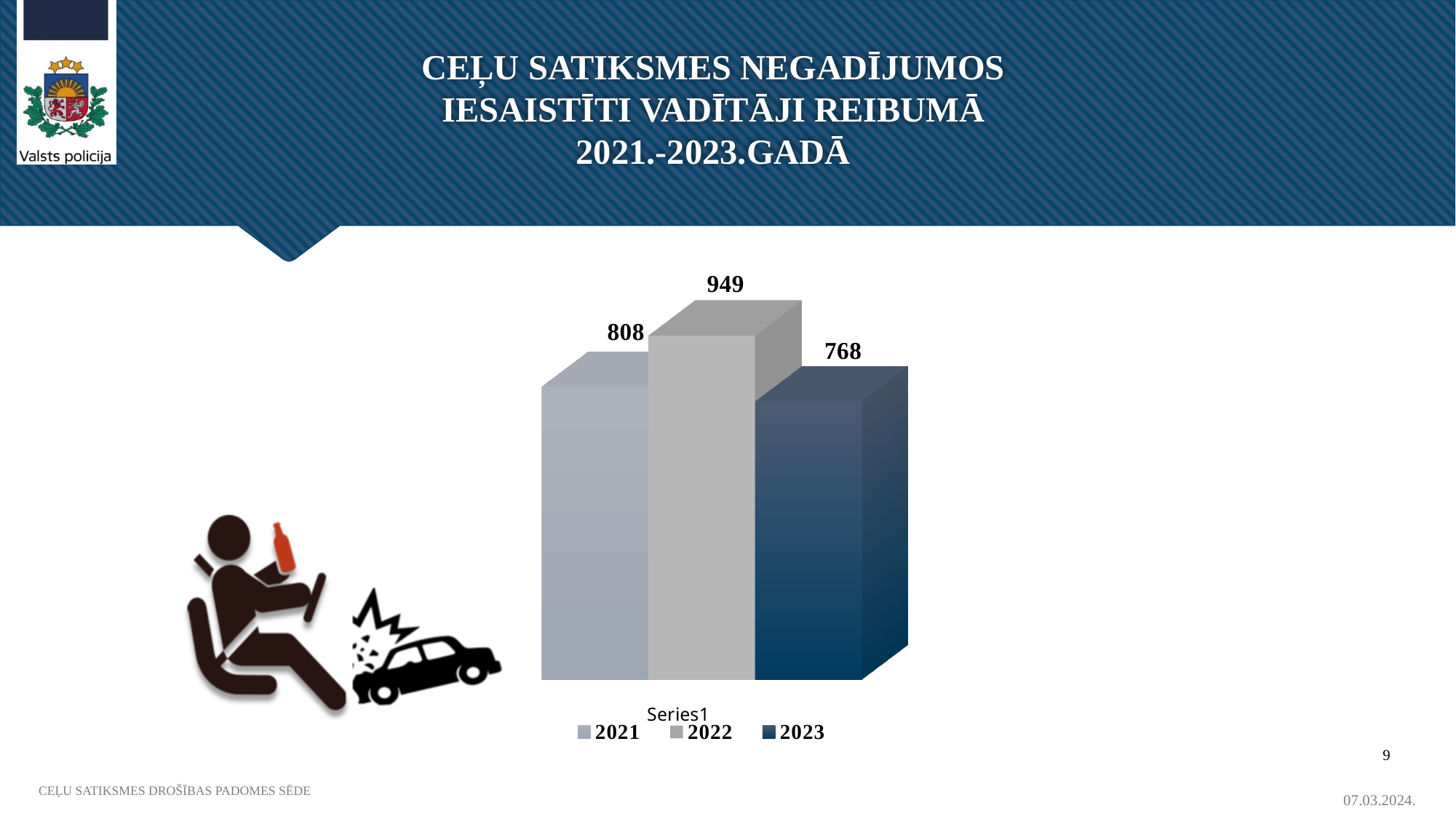
What kind of chart is shown on the slide? bar chart How many bars are shown in the chart? 3 What is the value for 2021? 808 Which is larger, the value for 2021 or the value for 2023? 2021 What is the difference between the values for 2022 and 2023? 181 What is the difference between the values for 2022 and 2021? 141 What is the value for 2023? 768 Which year has the lowest value? 2023 What is the category label shown below the bars? Series1 What is the value for 2022? 949 Which year has the highest value? 2022 How many entries does the legend list? 3